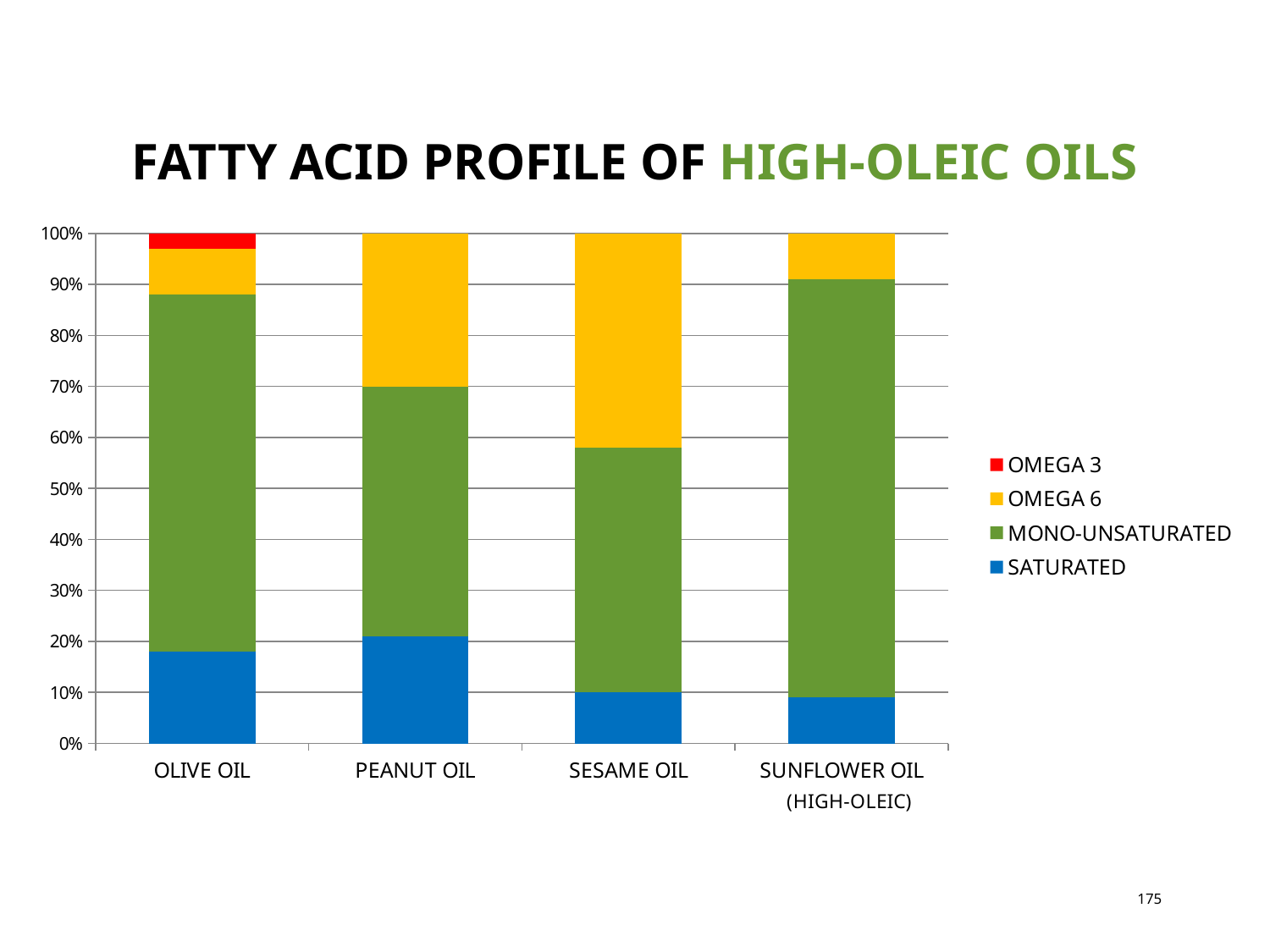
Which oil has the largest OMEGA 6 segment? SESAME OIL Which oil has the largest SATURATED segment? PEANUT OIL What kind of chart is shown on the slide? Stacked bar chart How many oils are shown on the x axis of the chart? 4 How many series does the legend list? 4 Which oil has the largest MONO-UNSATURATED segment? SUNFLOWER OIL (HIGH-OLEIC) Which is larger, the OMEGA 6 segment for PEANUT OIL or for SUNFLOWER OIL (HIGH-OLEIC)? PEANUT OIL Is the SATURATED value for OLIVE OIL greater or less than 20%? less Is the OMEGA 6 value for SESAME OIL greater or less than 30%? greater What is the total of the stacked bar for SUNFLOWER OIL (HIGH-OLEIC)? 100% Which oil is the only one showing an OMEGA 3 segment? OLIVE OIL Which is larger, the MONO-UNSATURATED segment for OLIVE OIL or for SESAME OIL? OLIVE OIL